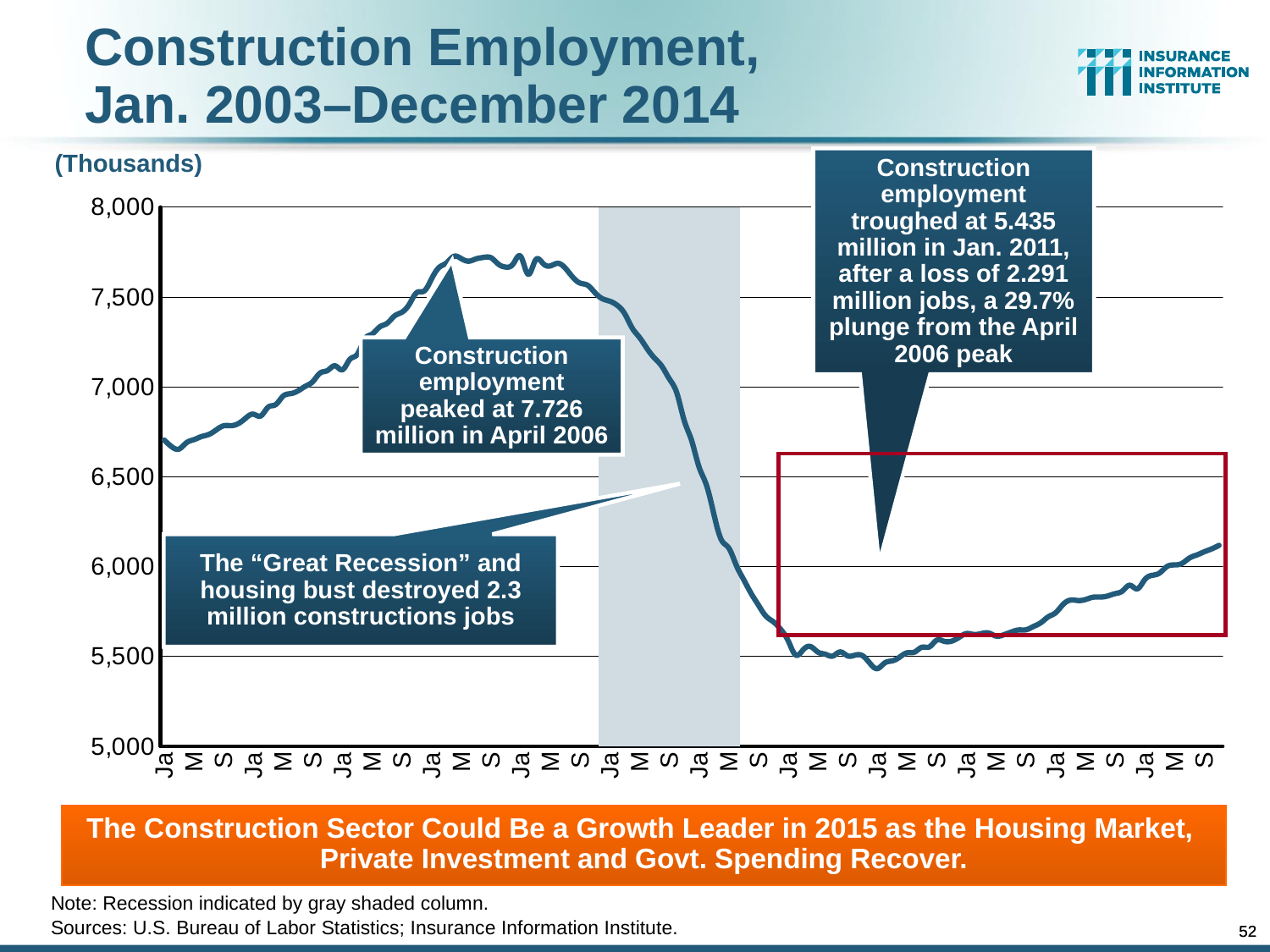
Does construction employment rise or fall from January 2011 to the end of 2014? rise By what percentage did construction employment plunge from the April 2006 peak to the Jan. 2011 trough? 29.7% What kind of chart is shown on the slide? Line chart Does construction employment rise or fall between the April 2006 peak and January 2011? fall In what units are the values on the vertical axis expressed? Thousands Is the value for construction employment in January 2003 greater or less than 6,500? greater At what level did construction employment peak, according to the callout on the chart? 7.726 million In which month and year did construction employment peak? April 2006 At what level did construction employment trough, according to the callout on the chart? 5.435 million What is the title of the chart on the slide? Construction Employment, Jan. 2003–December 2014 How many jobs were lost between the April 2006 peak and the Jan. 2011 trough, according to the chart? 2.291 million In which month and year did construction employment reach its trough? Jan. 2011